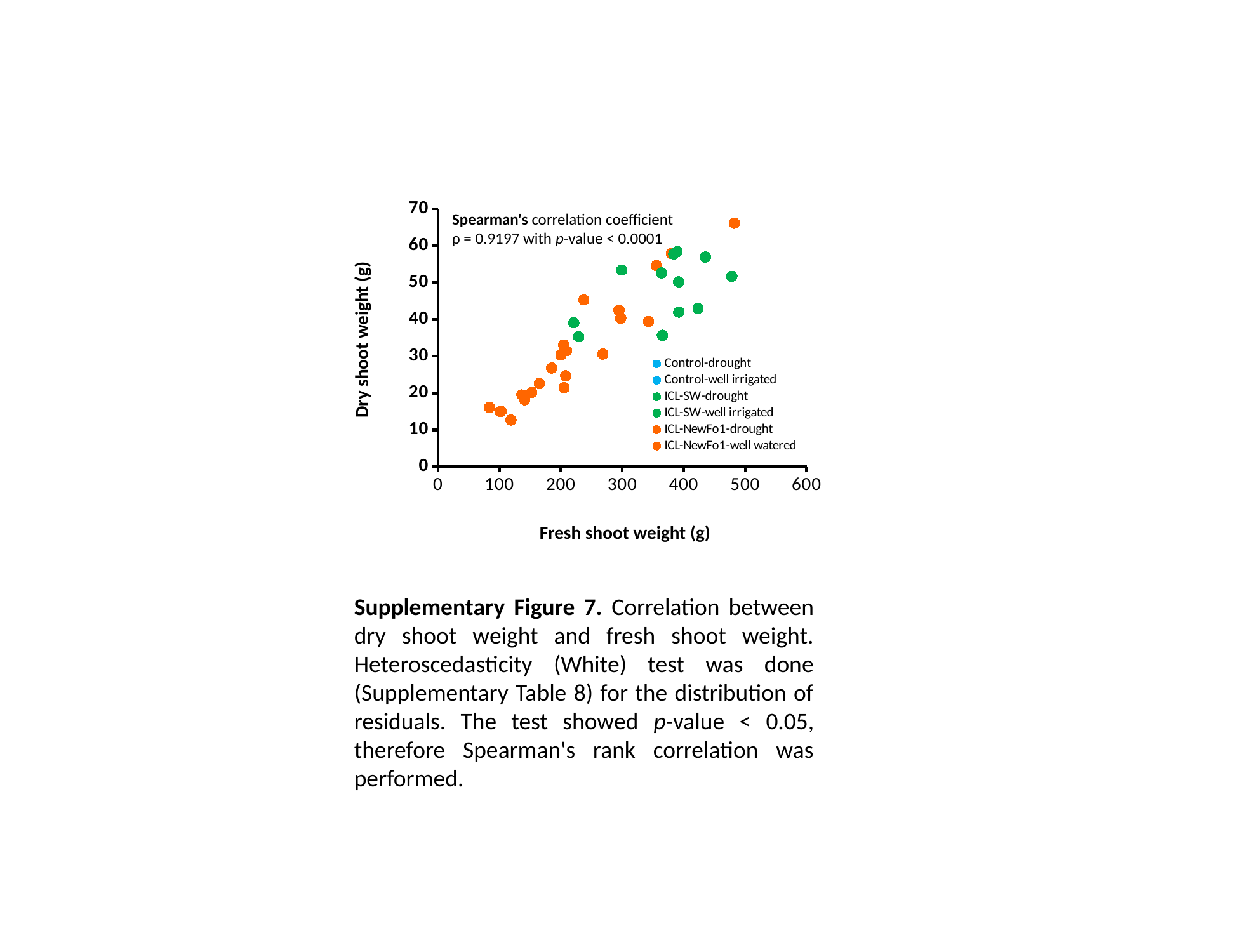
Is the smallest fresh shoot weight plotted on the chart greater or less than 100? less Is the lowest dry shoot weight plotted on the chart greater or less than 20? less What is the title of the x axis of the chart? Fresh shoot weight (g) Do the dry shoot weight values generally rise or fall as fresh shoot weight increases along the x axis? Rise How many series does the legend of the chart list? 6 What Spearman's correlation coefficient (ρ) is printed on the chart? 0.9197 What kind of chart is shown on the slide? Scatter plot Is the dry shoot weight of the point with the highest fresh shoot weight greater or less than 50? greater